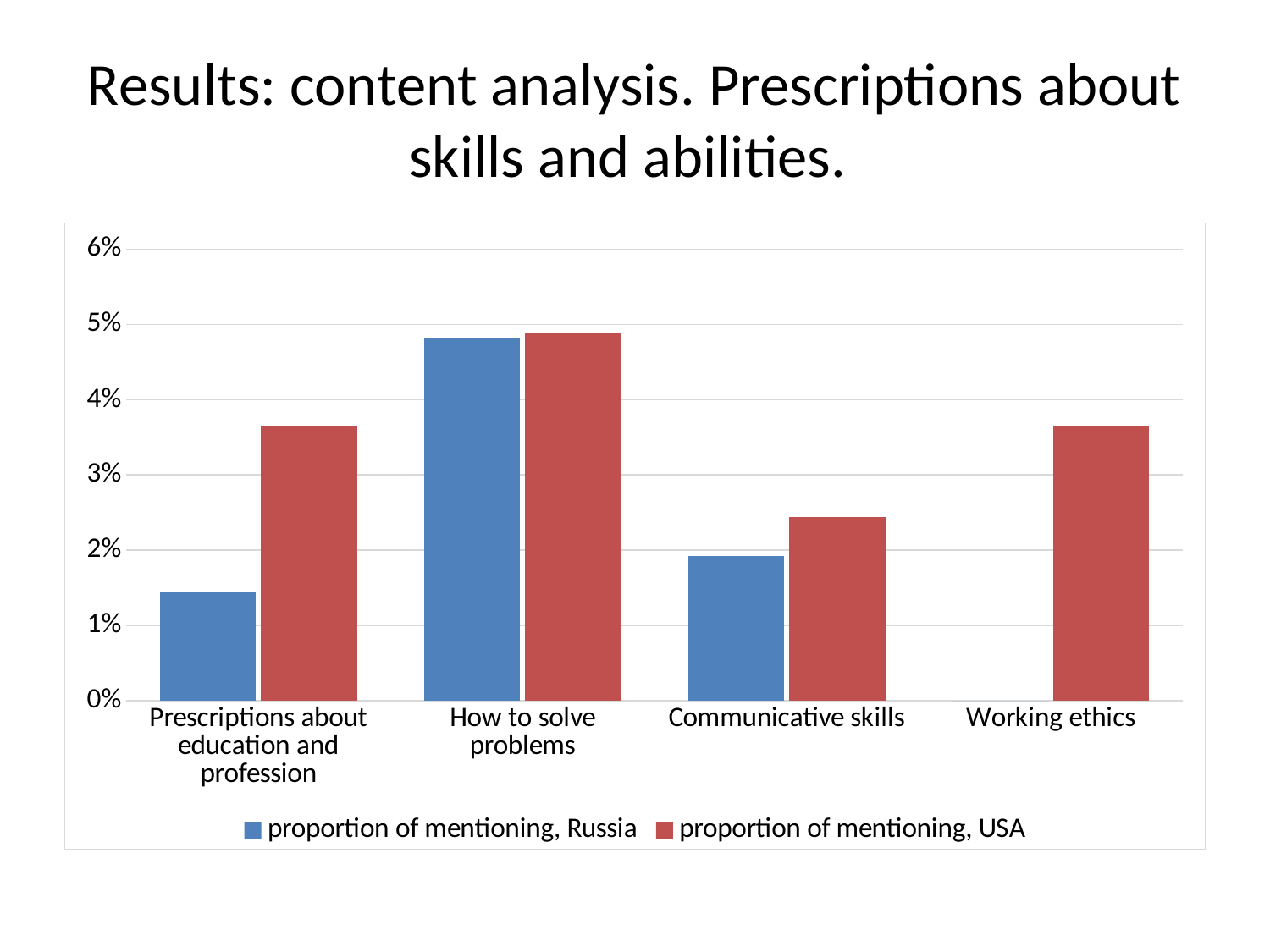
What colour are the bars for 'proportion of mentioning, USA' in the chart? red How many categories are shown on the x axis of the chart? 4 Is the value for 'proportion of mentioning, Russia' in 'Prescriptions about education and profession' greater or less than 2%? less For 'Communicative skills', which is larger: the Russia value or the USA value? USA How many series does the chart's legend list? 2 Is the value for 'proportion of mentioning, USA' in 'Working ethics' greater or less than 3%? greater Which category has the highest value for 'proportion of mentioning, USA'? How to solve problems Which category has the lowest value for 'proportion of mentioning, USA'? Communicative skills For 'Prescriptions about education and profession', which is larger: the Russia value or the USA value? USA Which category has the highest value for 'proportion of mentioning, Russia'? How to solve problems What kind of chart is shown on the slide? bar chart Is the value for 'proportion of mentioning, Russia' in 'How to solve problems' greater or less than 4%? greater